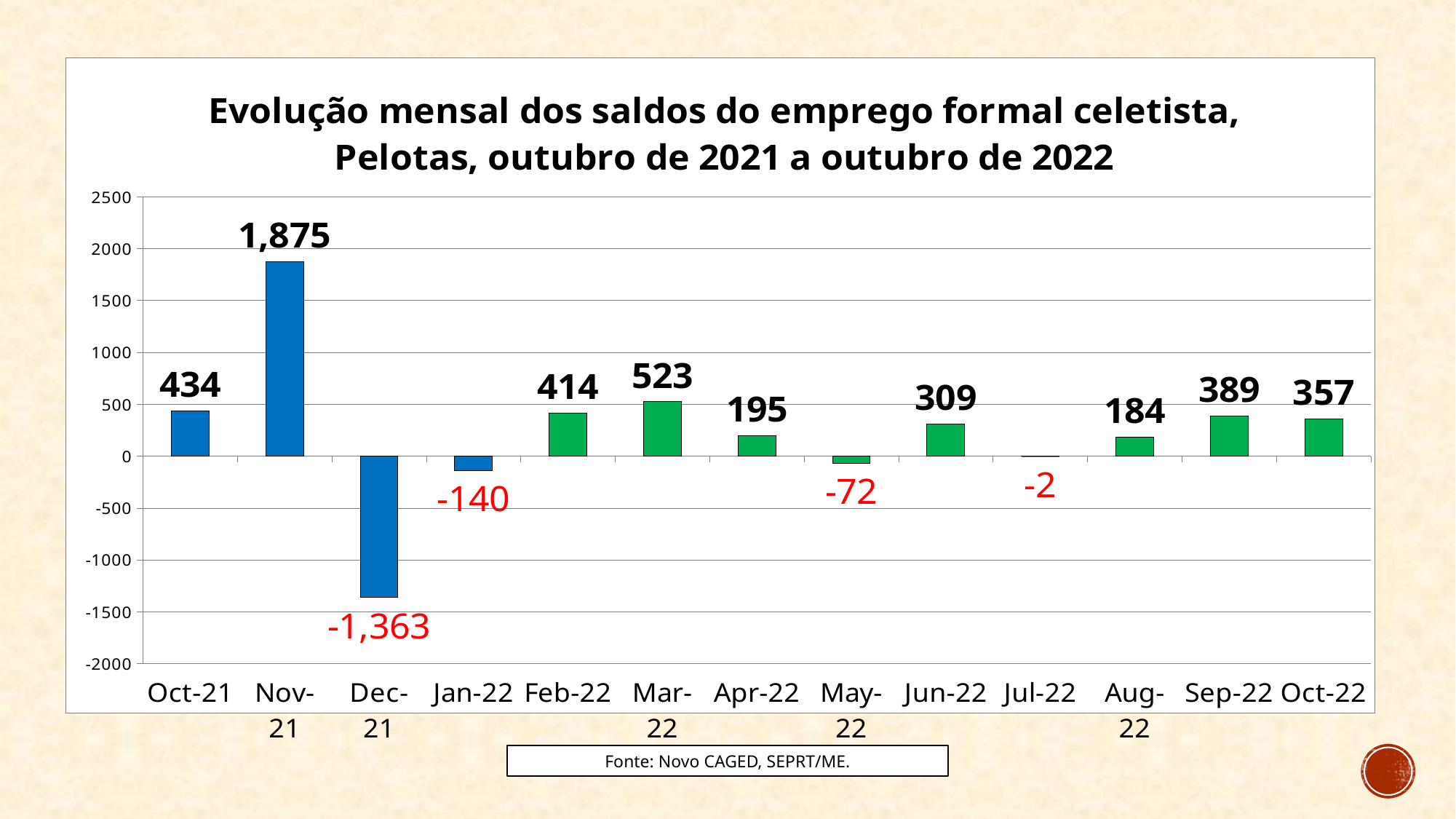
What is the value for Dec-21? -1,363 What is the value for Mar-22? 523 Which month has the lowest value? Dec-21 What kind of chart is this? bar chart Which month has the highest value? Nov-21 Which is larger, the value for Feb-22 or the value for Sep-22? Feb-22 What is the value for Jul-22? -2 What is the value for Nov-21? 1,875 How many months have a negative value? 4 How many months are shown on the x axis? 13 Is the value for Nov-21 greater or less than 1500? greater What is the difference between the values for Oct-21 and Oct-22? 77